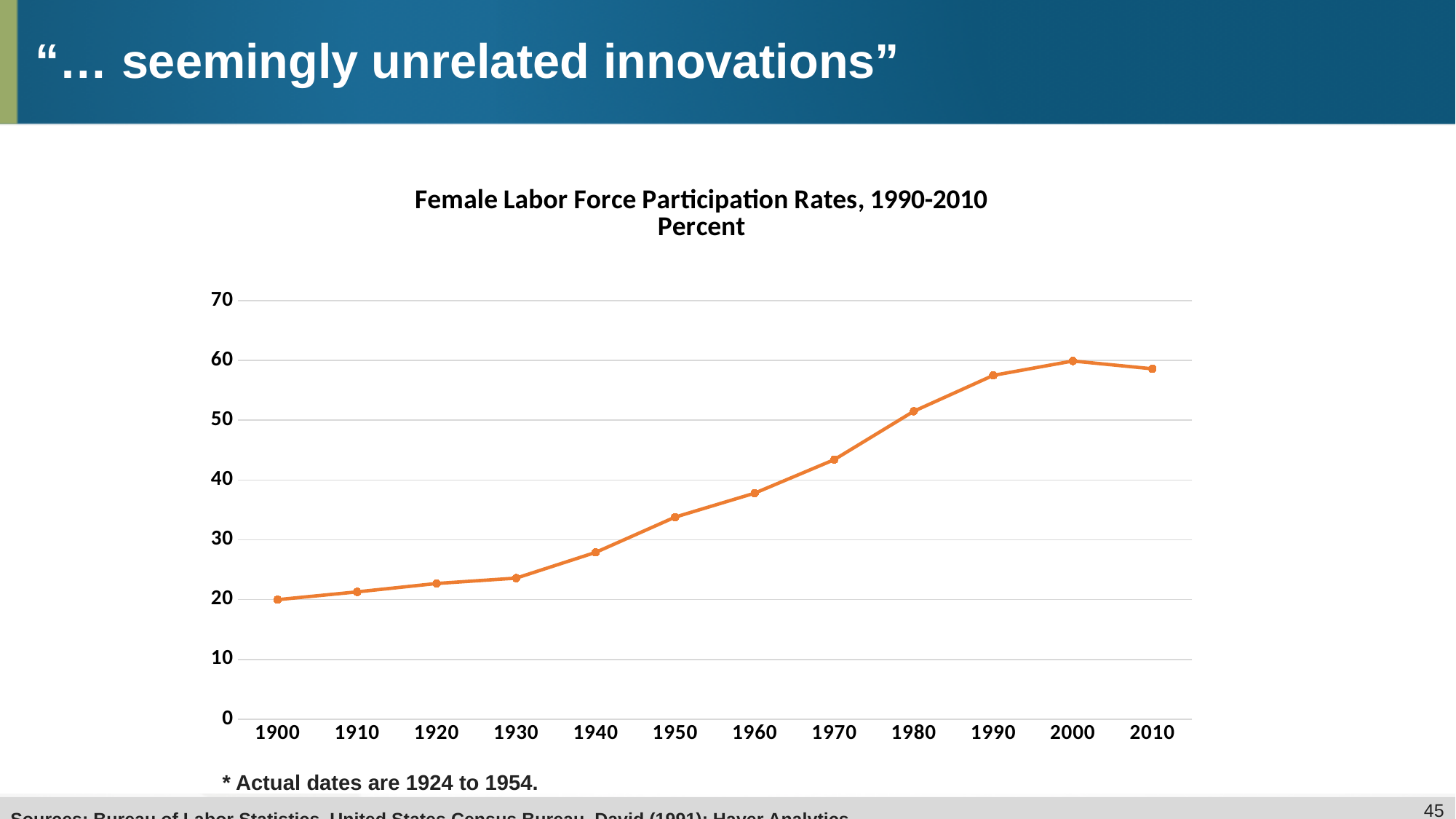
Do the values generally rise or fall from 1900 to 2000? rise Is the value for 1950 greater or less than 30? greater Which year has the lowest female labor force participation rate? 1900 Is the value for 1960 greater or less than 40? less What kind of chart is shown on the slide? line chart In what unit are the values on the chart expressed, according to the subtitle? Percent Which year has the highest female labor force participation rate? 2000 Which year has a higher participation rate, 1950 or 1980? 1980 How many data points are plotted on the line? 12 Is the value for 1970 greater or less than 50? less What is the title of the chart? Female Labor Force Participation Rates, 1990-2010